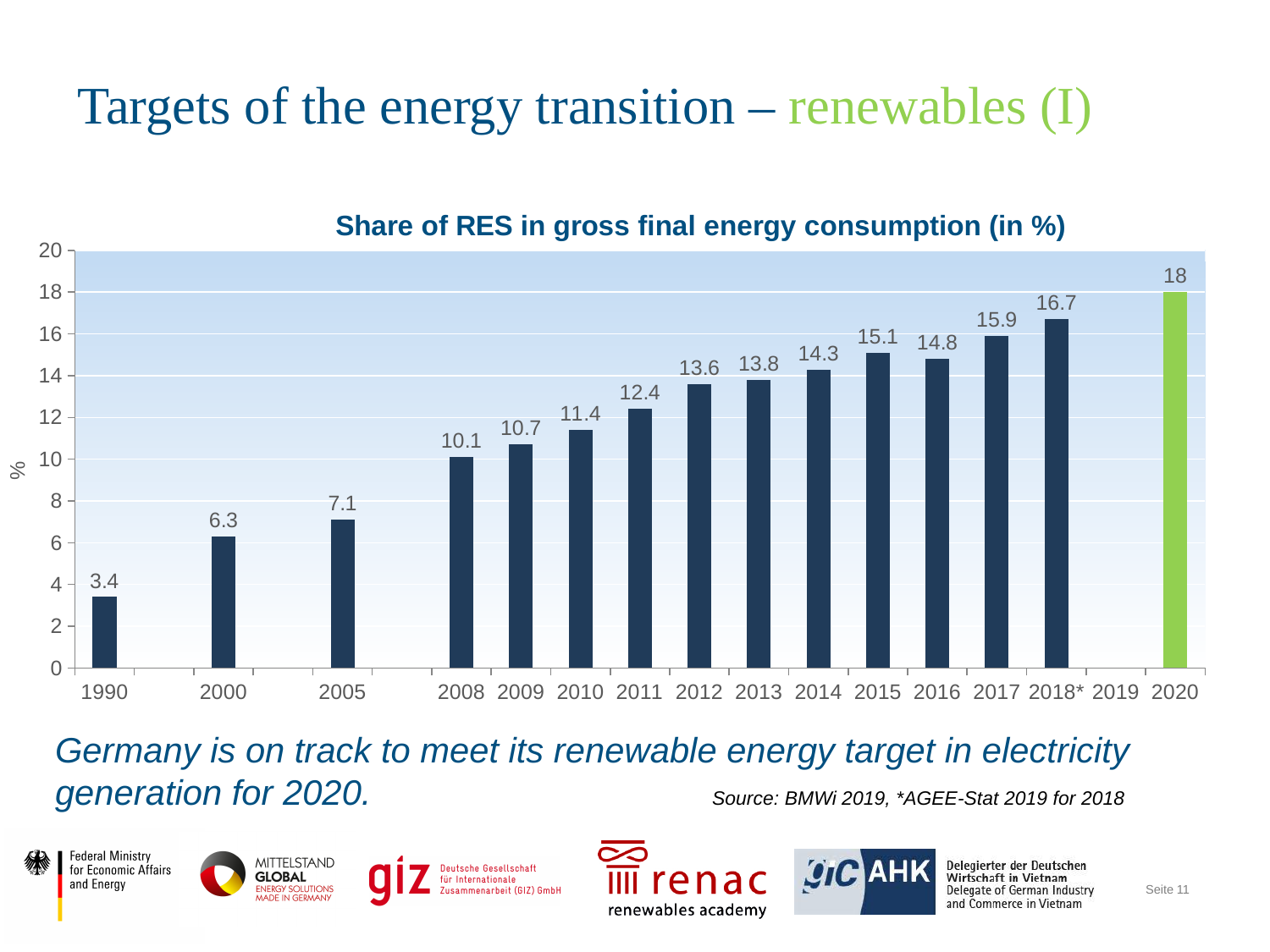
What is the value shown for 2020? 18 What is the share of RES in gross final energy consumption for 1990? 3.4 Which is larger, the value for 2015 or the value for 2016? 2015 Which year has the highest value in the chart? 2020 What type of chart is shown on the slide? Bar chart What value is shown for 2018* in the chart? 16.7 What is the title of the chart? Share of RES in gross final energy consumption (in %) What is the value shown for 2012? 13.6 Which year has the lowest value in the chart? 1990 What is the difference between the values for 2020 and 2018*? 1.3 What is the difference between the values for 2000 and 1990? 2.9 Do the values generally rise or fall from 1990 to 2020? Rise